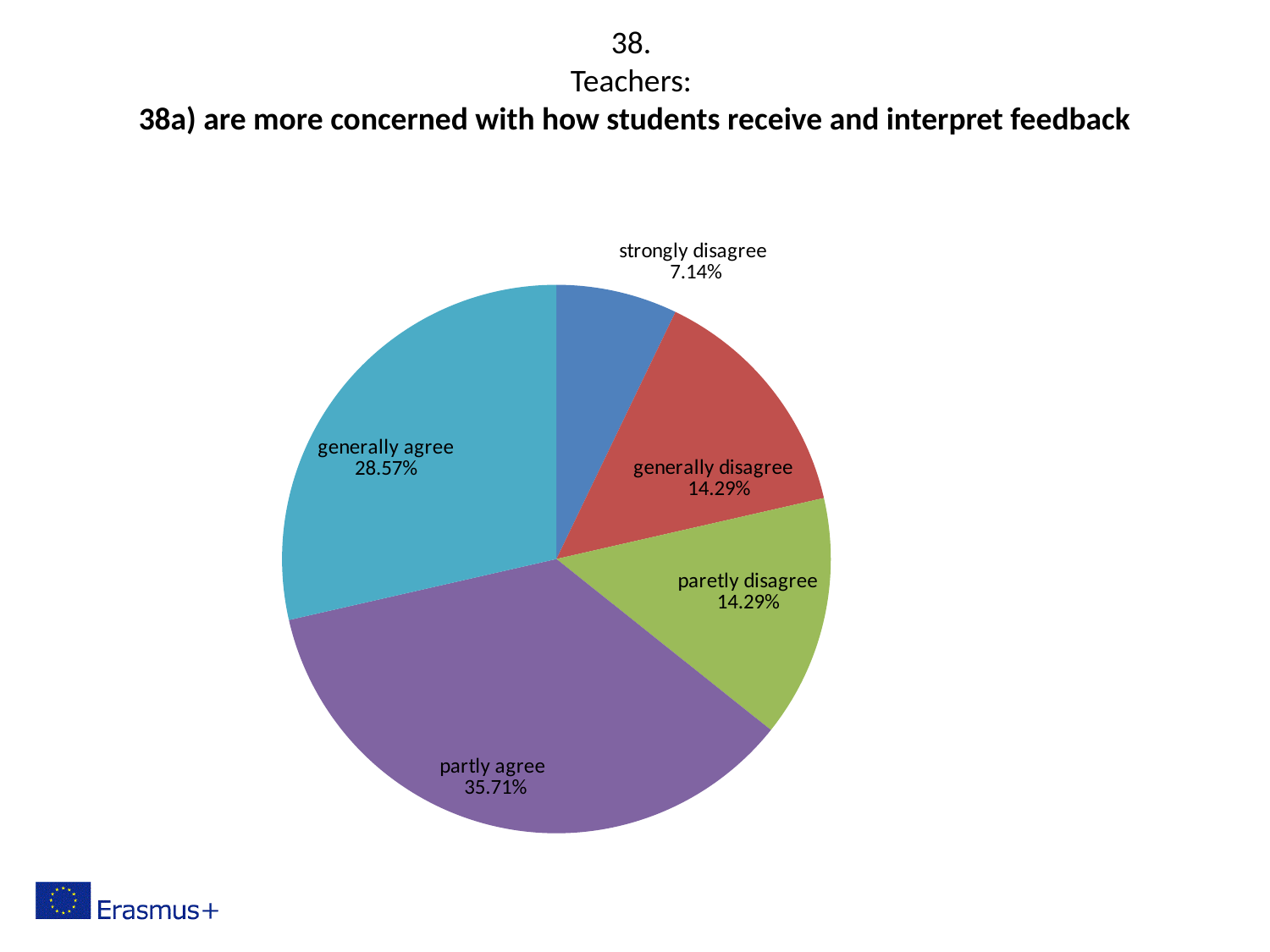
Which category has the smallest slice of the pie? strongly disagree Which category has the largest slice of the pie? partly agree What share of the pie is labelled "generally disagree"? 14.29% What share of the pie is labelled "generally agree"? 28.57% What is the difference between the shares for "partly agree" and "generally agree"? 7.14% What is the combined share of "generally disagree" and "paretly disagree"? 28.58% What colour is the "partly agree" slice? purple What share of the pie is labelled "partly agree"? 35.71% Which is larger, the share for "generally agree" or the share for "generally disagree"? generally agree How many slices does the pie chart have? 5 What kind of chart is shown on the slide? pie chart